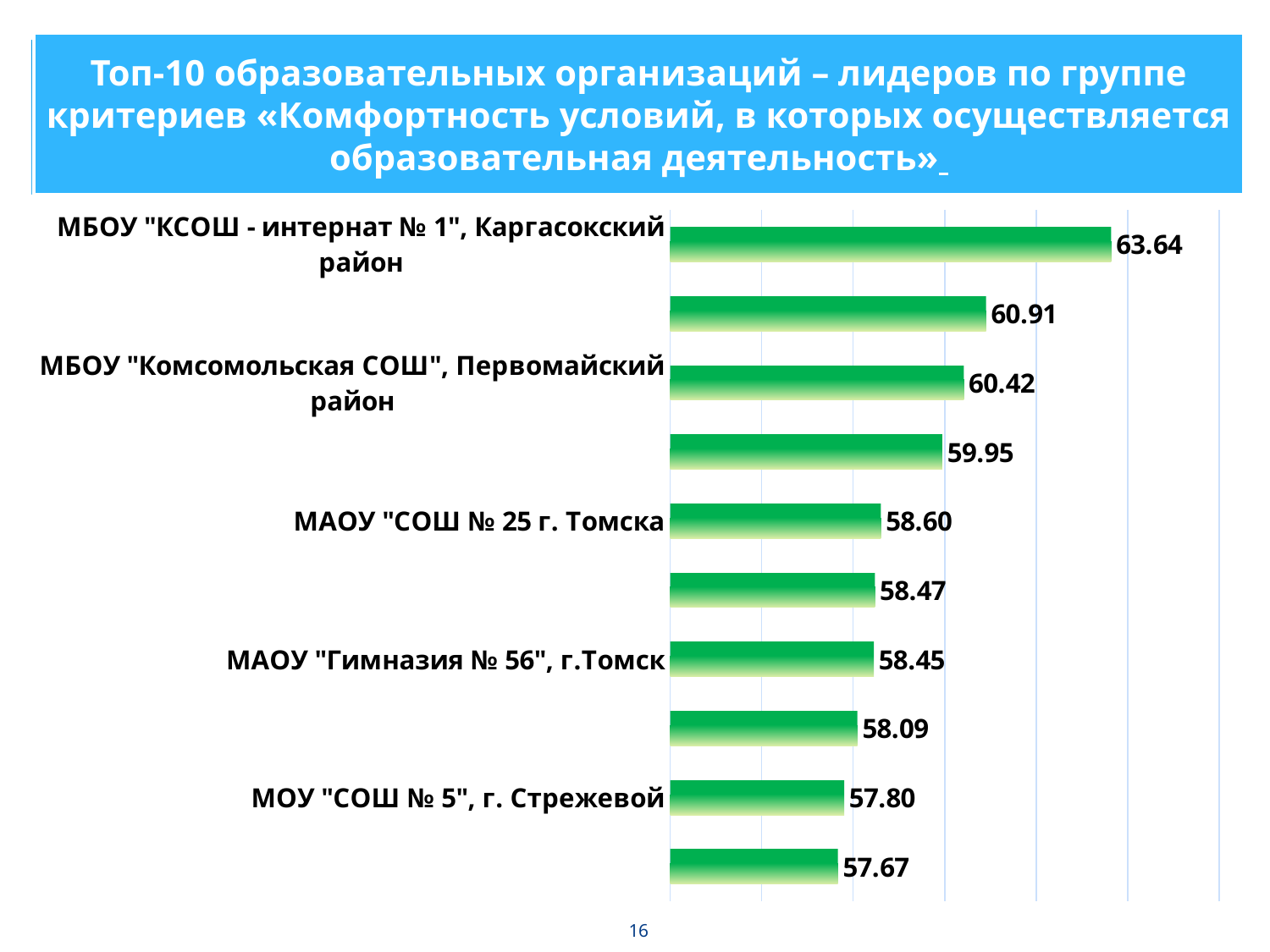
What is the value for МОУ "СОШ № 5", г. Стрежевой? 57.80 What is the value for МАОУ "СОШ № 25 г. Томска"? 58.60 What is the value for МБОУ "Комсомольская СОШ", Первомайский район? 60.42 What is the lowest value shown in the chart? 57.67 Which organisation has the highest value in the chart? МБОУ "КСОШ - интернат № 1", Каргасокский район What kind of chart is shown on the slide? Bar chart How many bars are plotted in the chart? 10 What is the difference between the values for МБОУ "КСОШ - интернат № 1", Каргасокский район and МБОУ "Комсомольская СОШ", Первомайский район? 3.22 What colour are the bars in the chart? Green What is the value for МБОУ "КСОШ - интернат № 1", Каргасокский район? 63.64 Which has a larger value: МАОУ "СОШ № 25 г. Томска" or МОУ "СОШ № 5", г. Стрежевой? МАОУ "СОШ № 25 г. Томска" What is the value for МАОУ "Гимназия № 56", г.Томск? 58.45